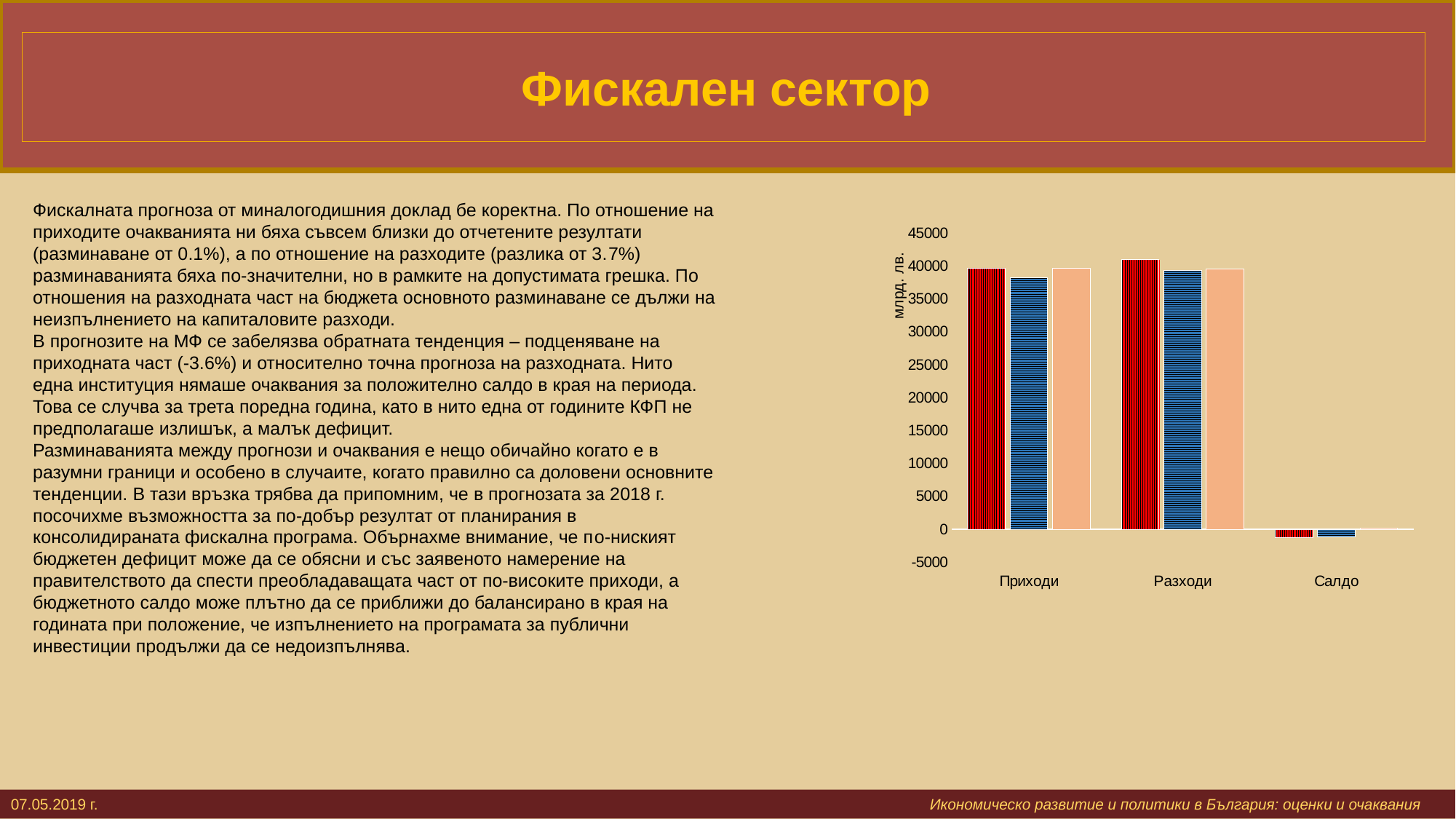
Is the value of the red bar for Салдо greater or less than 0? less Is the value of the red bar for Приходи greater or less than 35000? greater Which is larger: the red bar for Разходи or the red bar for Приходи? Разходи Which is larger: the red bar for Приходи or the red bar for Салдо? Приходи What is the highest value shown on the vertical axis of the chart? 45000 How many categories are shown on the x axis of the chart? 3 How many bars are plotted for the category Приходи? 3 Is the value of the blue bar for Приходи greater or less than 40000? less What is the label on the vertical axis of the chart? млрд. лв. What kind of chart is shown on the slide? bar chart Which category has the lowest values in the chart? Салдо